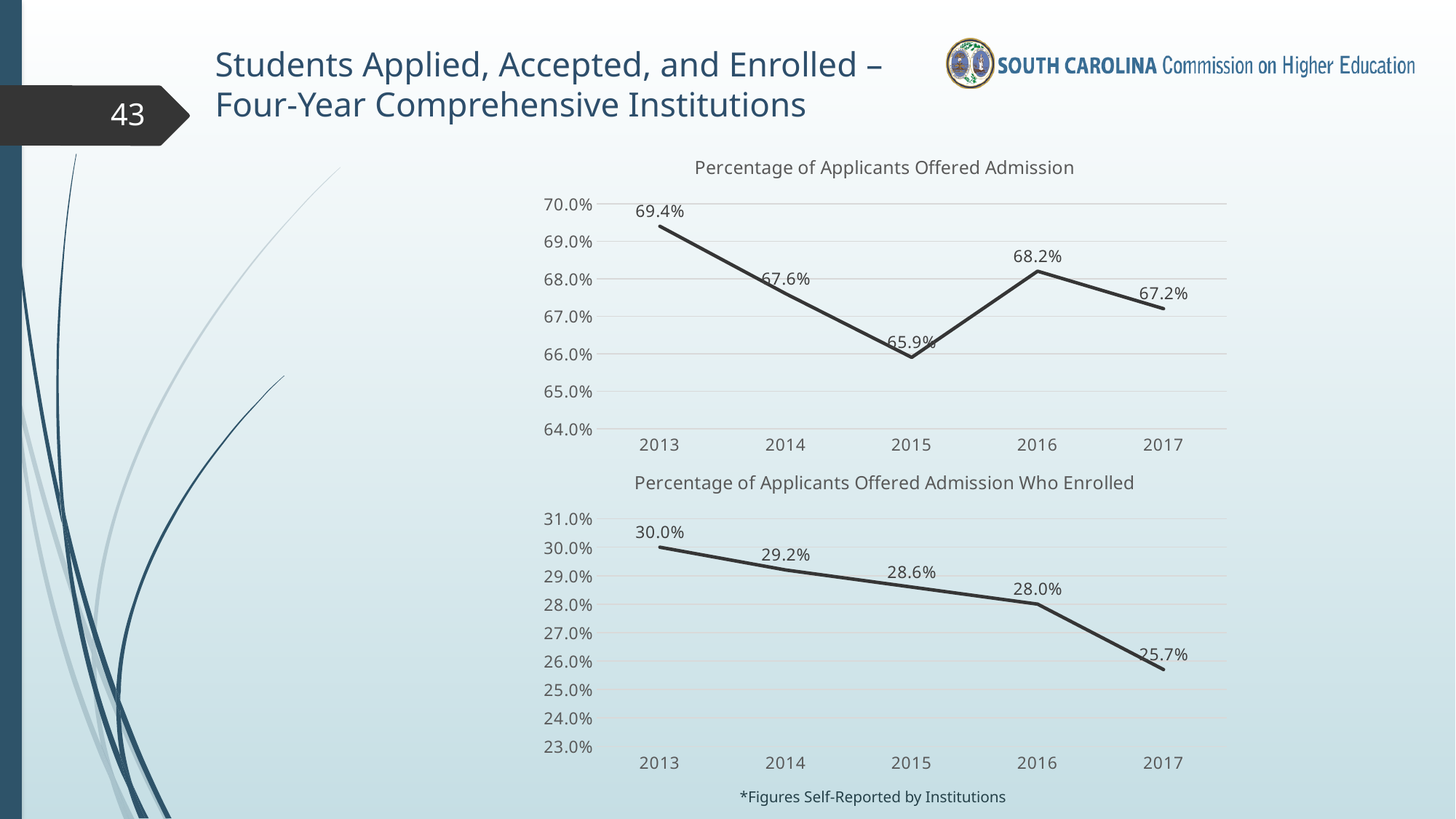
In the 'Percentage of Applicants Offered Admission' chart, what is the value for 2013? 69.4% What is the title of the bottom chart on the slide? Percentage of Applicants Offered Admission Who Enrolled In the 'Percentage of Applicants Offered Admission Who Enrolled' chart, what is the value for 2017? 25.7% In the 'Percentage of Applicants Offered Admission Who Enrolled' chart, do the values rise or fall from 2013 to 2017? fall What kind of chart is the 'Percentage of Applicants Offered Admission' chart? line chart In the 'Percentage of Applicants Offered Admission Who Enrolled' chart, what is the difference between the 2013 and 2017 values? 4.3% In the 'Percentage of Applicants Offered Admission Who Enrolled' chart, what is the value for 2015? 28.6% In the 'Percentage of Applicants Offered Admission' chart, which is larger, the value for 2014 or the value for 2016? 2016 In the 'Percentage of Applicants Offered Admission' chart, which year has the lowest value? 2015 In the 'Percentage of Applicants Offered Admission' chart, which year has the highest value? 2013 How many years are plotted in the 'Percentage of Applicants Offered Admission Who Enrolled' chart? 5 In the 'Percentage of Applicants Offered Admission' chart, what is the difference between the 2016 and 2017 values? 1.0%